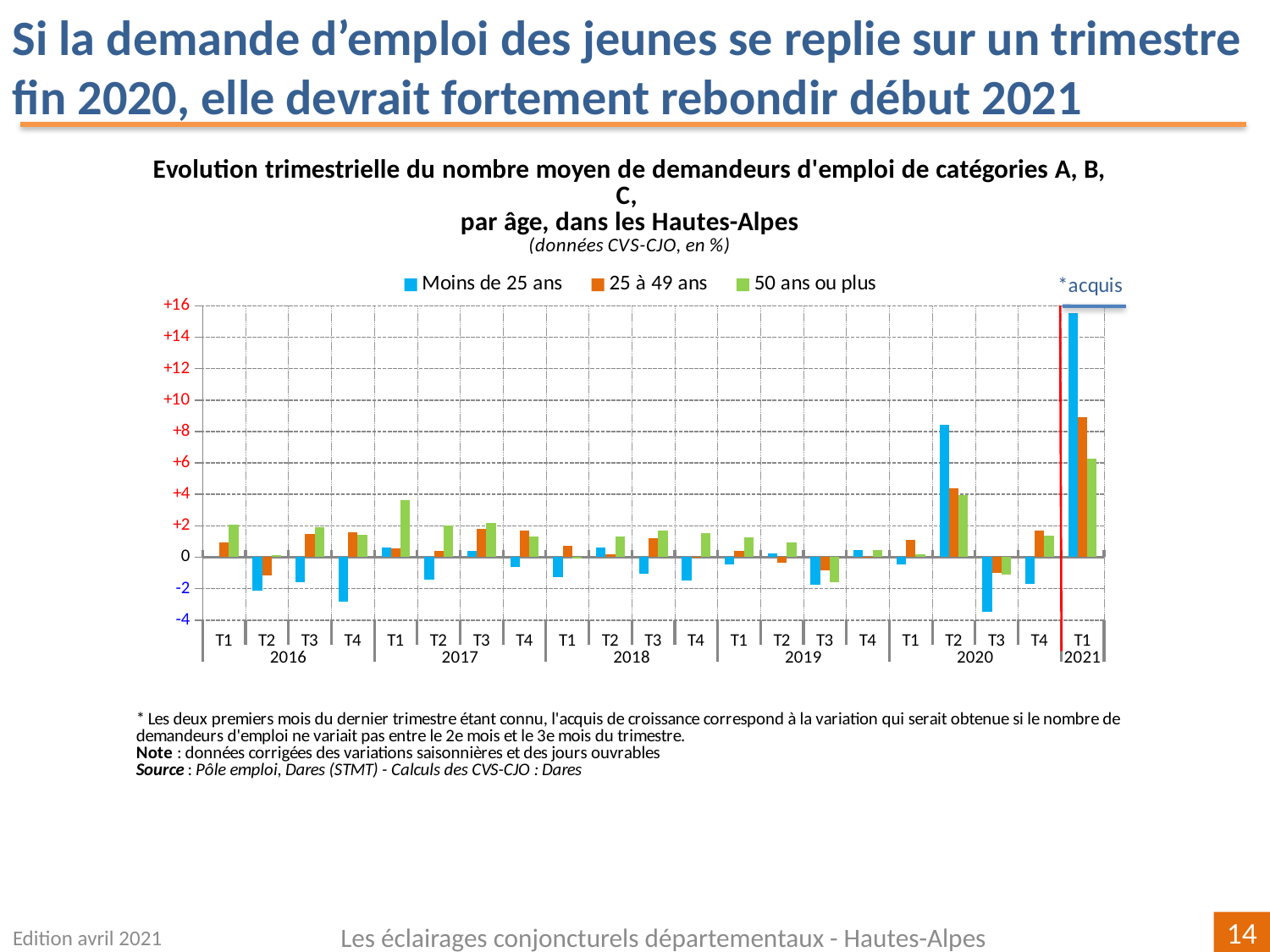
In T1 2021, which is larger: the value for Moins de 25 ans or for 25 à 49 ans? Moins de 25 ans In which quarter is the value for Moins de 25 ans the lowest? T3 2020 Which quarter is marked as *acquis on the chart? T1 2021 Is the value for 50 ans ou plus in T1 2017 greater or less than +2? greater Is the value for Moins de 25 ans in T2 2020 greater or less than +6? greater What kind of chart is shown on the slide? bar chart In which quarter is the value for Moins de 25 ans the highest? T1 2021 Is the value for Moins de 25 ans in T1 2021 greater or less than +14? greater In which quarter is the value for 50 ans ou plus the highest? T1 2021 How many series does the legend list? 3 How many quarters are shown on the x axis? 21